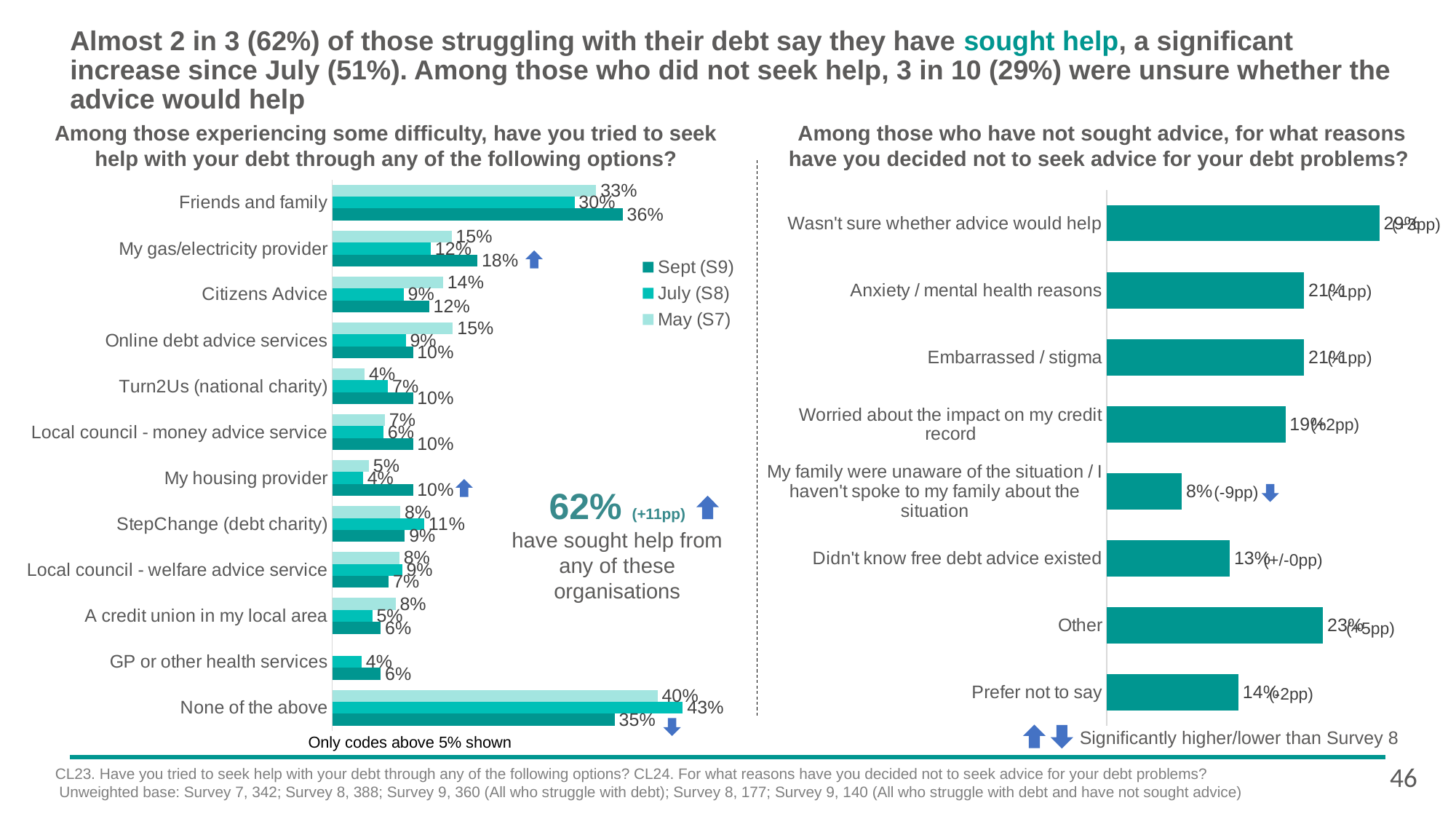
What kind of chart is the left chart? Bar chart In the right chart, what is the difference between the values for Other and Prefer not to say? 9 percentage points In the right chart, which reason has the lowest value? My family were unaware of the situation / I haven't spoke to my family about the situation In the left chart, which has the larger Sept (S9) value: My gas/electricity provider or Citizens Advice? My gas/electricity provider In the left chart, what is the Sept (S9) value for Friends and family? 36% In the left chart, what is the difference between the Sept (S9) and July (S8) values for My gas/electricity provider? 6 percentage points In the right chart, which reason has the highest value? Wasn't sure whether advice would help In the left chart, did the value for Turn2Us (national charity) rise or fall from May (S7) to Sept (S9)? Rise In the left chart, what is the July (S8) value for Citizens Advice? 9% In the left chart, what is the May (S7) value for None of the above? 40% How many reasons are plotted in the right chart? 8 How many series does the legend of the left chart list? 3